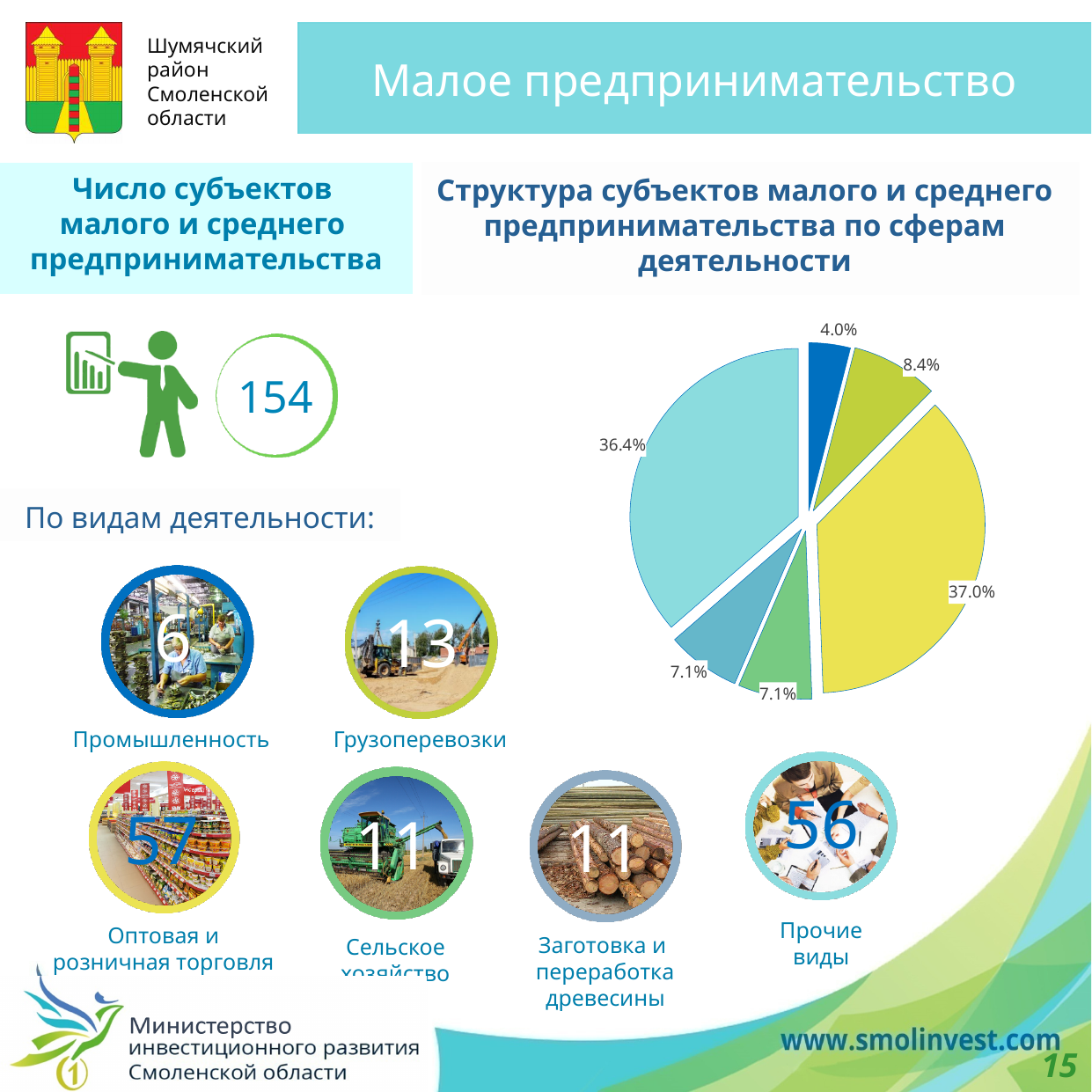
What is the largest percentage shown on the pie chart? 37.0% Which is larger on the pie chart: the yellow-green slice (8.4%) or the green slice (7.1%)? The yellow-green slice (8.4%) What percentage is labelled on the light cyan slice of the pie chart? 36.4% How many slices does the pie chart have? 6 What is the combined share of the two slices labelled 7.1% on the pie chart? 14.2% What percentage is labelled on the dark blue slice of the pie chart? 4.0% What type of chart is shown under the heading «Структура субъектов малого и среднего предпринимательства по сферам деятельности»? Pie chart What is the difference between the 37.0% slice and the 36.4% slice of the pie chart? 0.6 percentage points What is the title of the pie chart? Структура субъектов малого и среднего предпринимательства по сферам деятельности What is the difference between the largest slice (37.0%) and the smallest slice (4.0%) of the pie chart? 33.0 percentage points What percentage is labelled on the yellow slice of the pie chart? 37.0% What is the smallest percentage shown on the pie chart? 4.0%